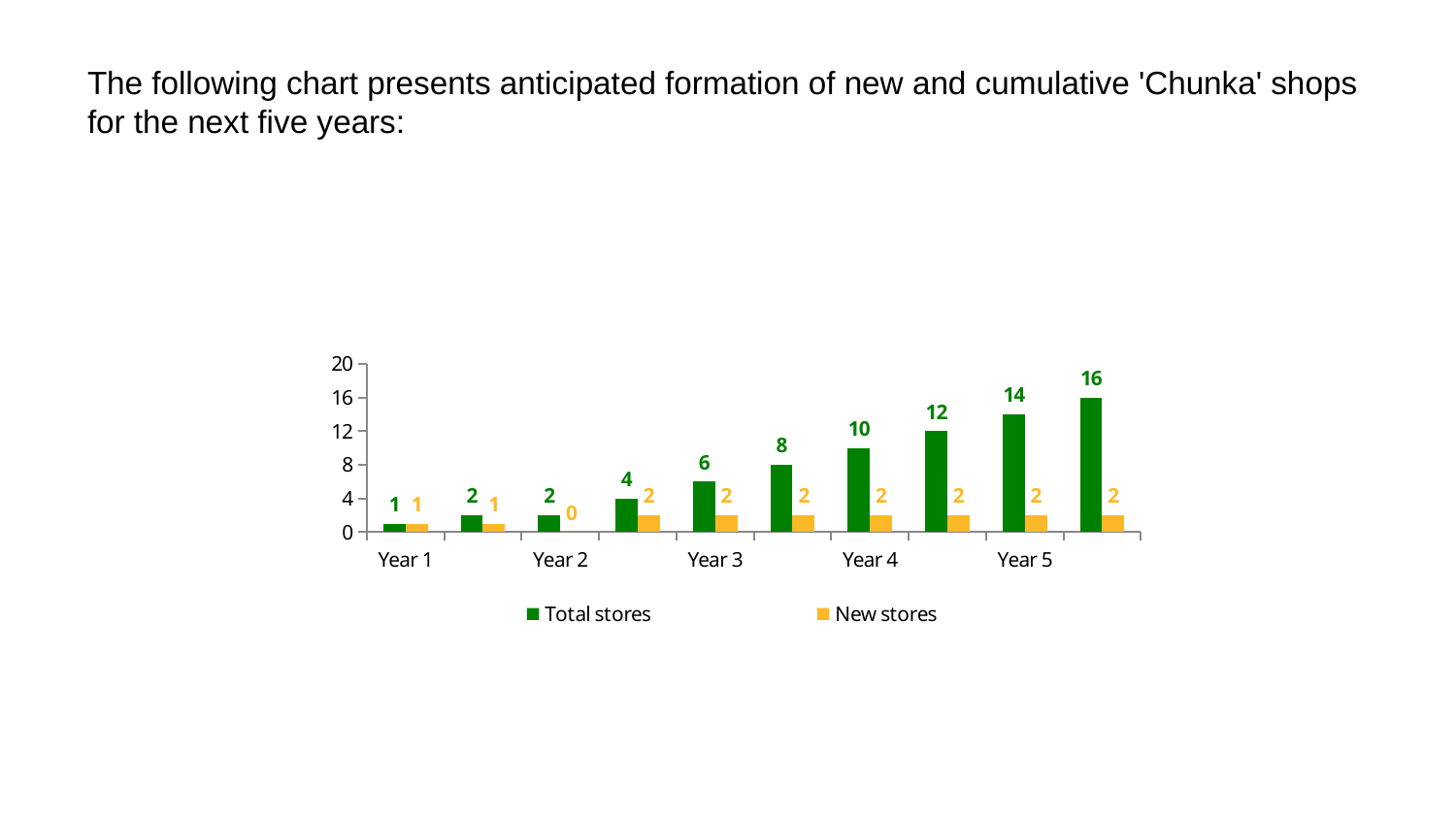
Which is larger: the Total stores value in the first bar group or in the last bar group? The last bar group What is the New stores value for the last (rightmost) bar group? 2 How many series does the legend list? 2 What is the difference between the highest and lowest Total stores values? 15 Is the highest Total stores value greater or less than 12? greater What is the highest value shown for the Total stores series? 16 What kind of chart is shown on the slide? Bar chart How many year labels appear on the x axis? 5 What is the lowest value shown for the Total stores series? 1 Do the Total stores values rise or fall from Year 1 to Year 5? Rise What is the lowest value shown for the New stores series? 0 What is the Total stores value for the last (rightmost) bar group? 16